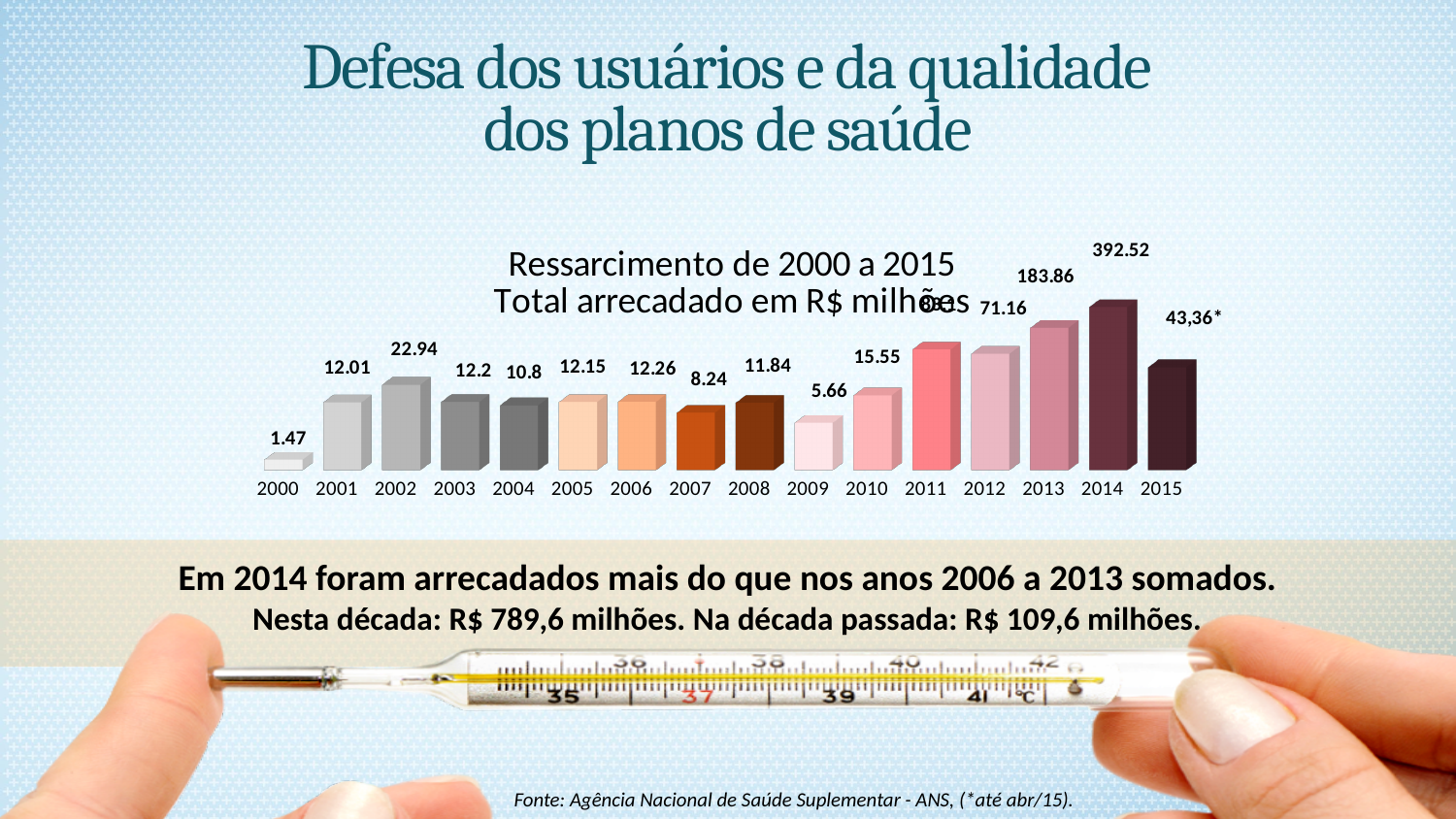
What is the value for 2014? 392.52 What type of chart is shown on the slide? bar chart Do the values rise or fall from 2012 to 2014? rise What is the value for 2000? 1.47 Which year has the lowest value? 2000 What is the difference between the values for 2014 and 2013? 208.66 Which is larger, the value for 2002 or the value for 2001? 2002 How many years are shown on the x axis? 16 What is the value for 2015? 43,36* What is the chart's title? Ressarcimento de 2000 a 2015 Total arrecadado em R$ milhões What is the value for 2013? 183.86 Which year has the highest value? 2014